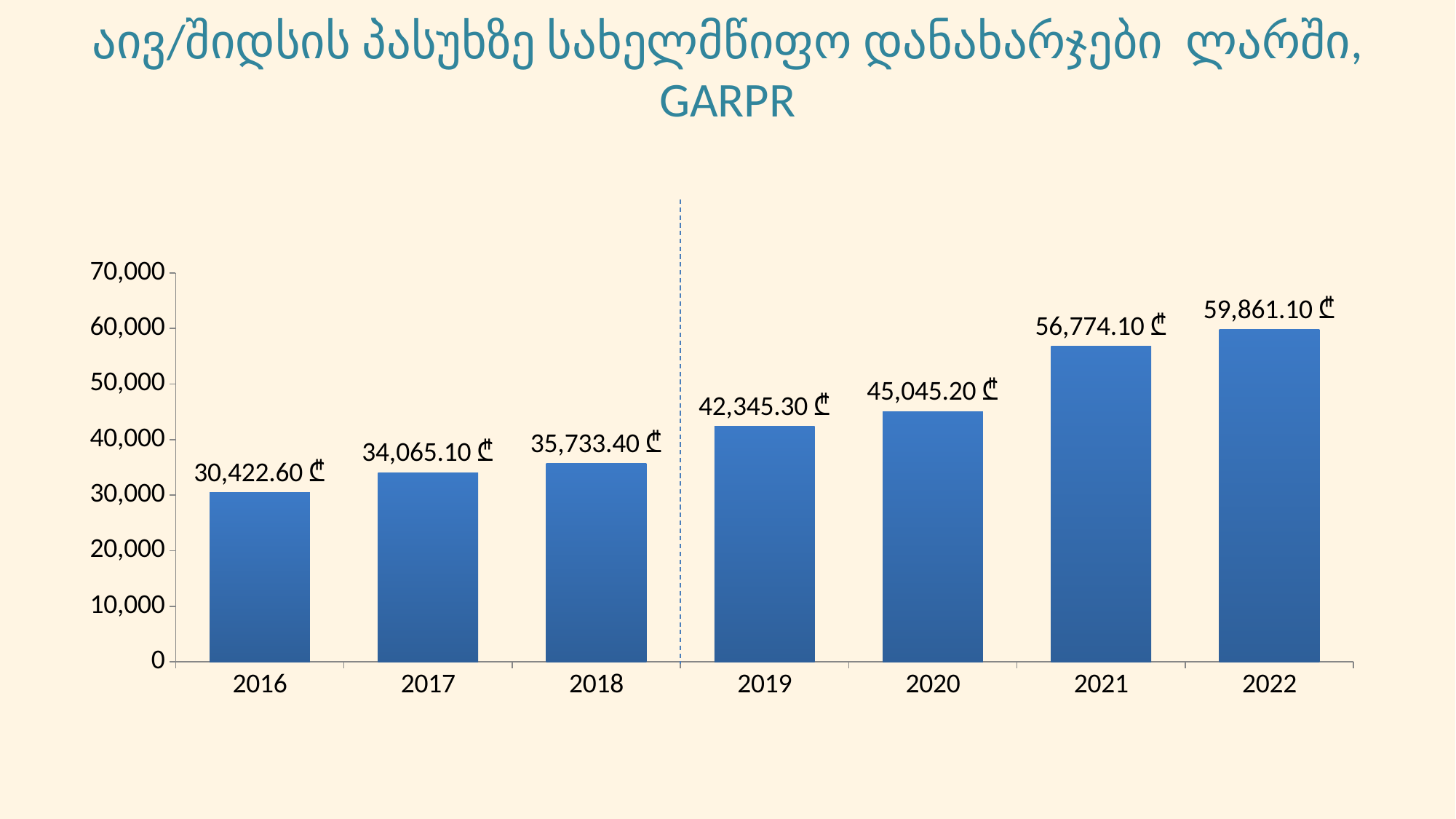
Which year has the highest value? 2022 Which is larger, the value for 2018 or the value for 2020? 2020 Is the value for 2020 greater or less than 40,000? greater What kind of chart is shown on the slide? bar chart What is the value shown for 2019? 42,345.30 ₾ What is the difference between the values for 2022 and 2021? 3,087.00 ₾ How many years are shown on the x axis? 7 Which year has the lowest value? 2016 Do the values rise or fall from 2016 to 2022? rise What is the value shown for 2021? 56,774.10 ₾ What is the value shown for 2016? 30,422.60 ₾ What is the difference between the values for 2019 and 2018? 6,611.90 ₾